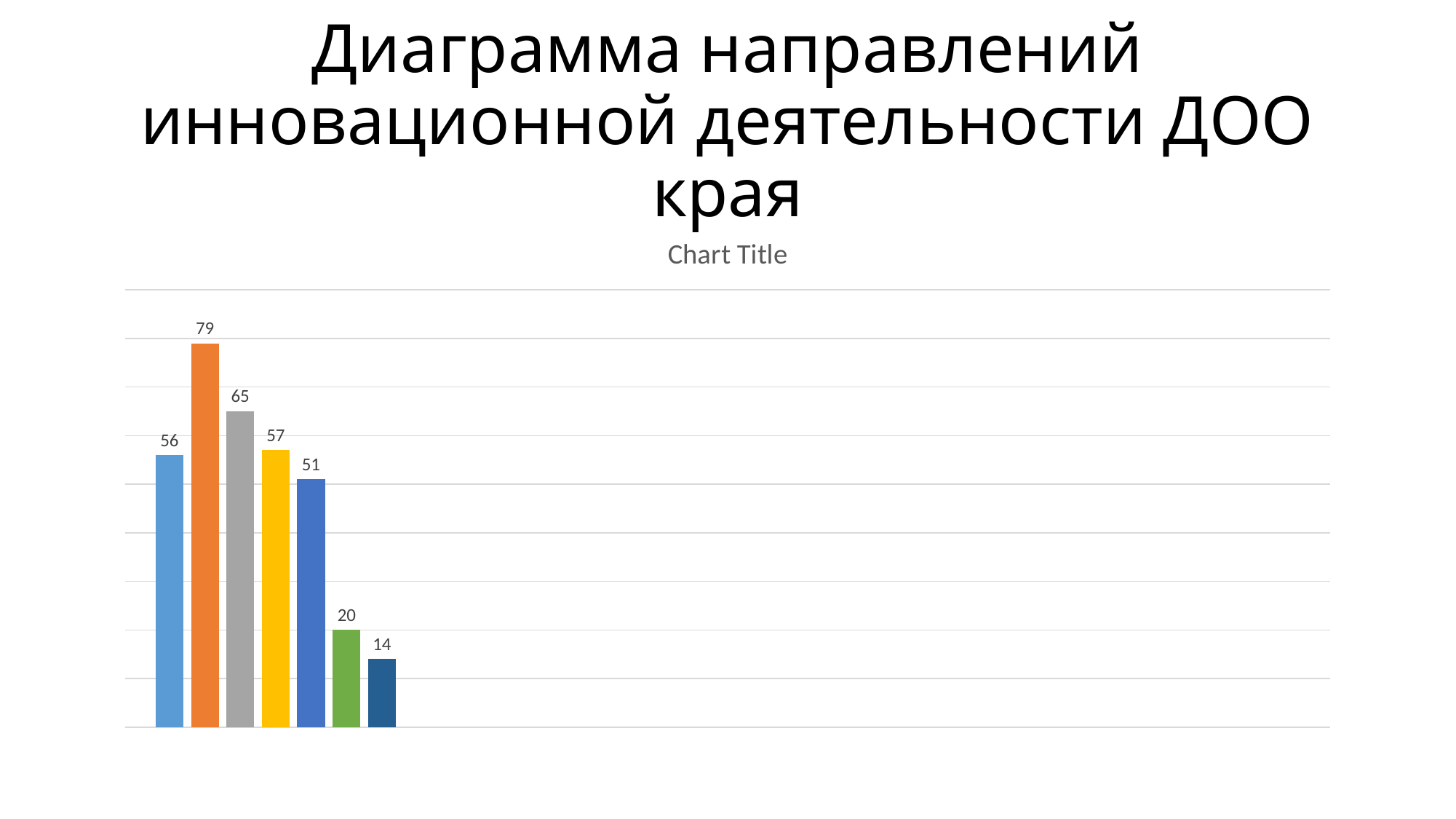
What is the value of the first (leftmost, light blue) bar? 56 Which bar has the lowest value? the rightmost dark blue bar, 14 Which bar has the highest value? the orange bar (second from the left), 79 What kind of chart is shown on the slide? bar chart How many bars are plotted in the chart? 7 What is the value of the orange bar (second from the left)? 79 What is the difference between the gray bar (65) and the yellow bar (57)? 8 What is the title printed directly above the chart area? Chart Title What is the value of the last (rightmost, dark blue) bar? 14 What is the difference between the highest bar (79) and the lowest bar (14)? 65 What is the value of the green bar? 20 Which is larger, the gray bar or the yellow bar? the gray bar (65)